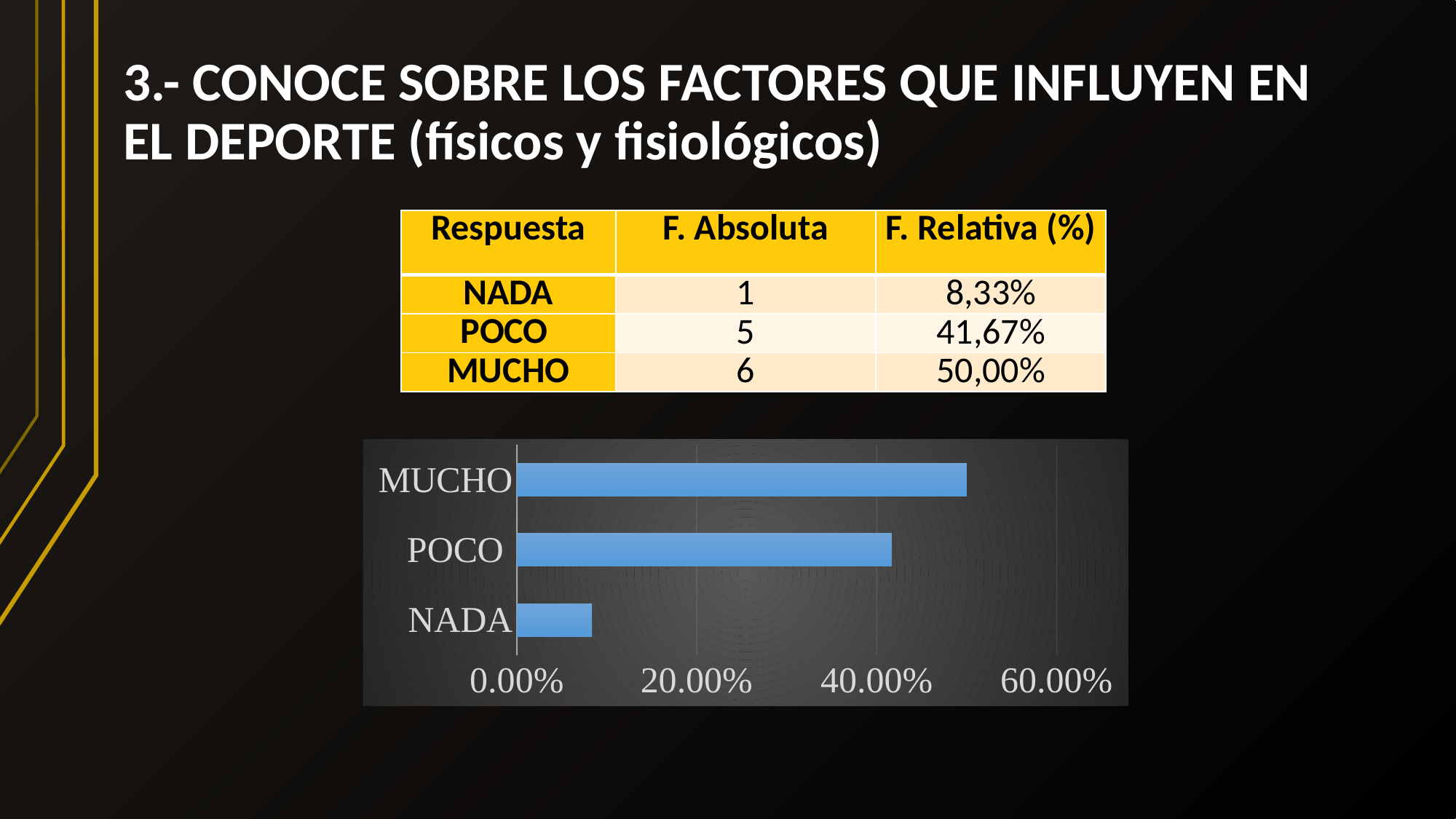
Which bar is longer, POCO or NADA? POCO Is the value for MUCHO greater or less than 40.00%? greater Which category has the shortest bar in the chart? NADA Is the value for NADA greater or less than 20.00%? less What is the highest tick label shown on the chart's horizontal axis? 60.00% According to the table on the slide, what is the relative frequency (F. Relativa) for MUCHO? 50,00% How many categories does the bar chart show? 3 What kind of chart is shown on the slide? bar chart According to the table on the slide, what is the relative frequency (F. Relativa) for NADA? 8,33% Which category has the longest bar in the chart? MUCHO Is the value for POCO greater or less than 20.00%? greater Using the table values, what is the difference between the relative frequencies of MUCHO and POCO? 8,33%